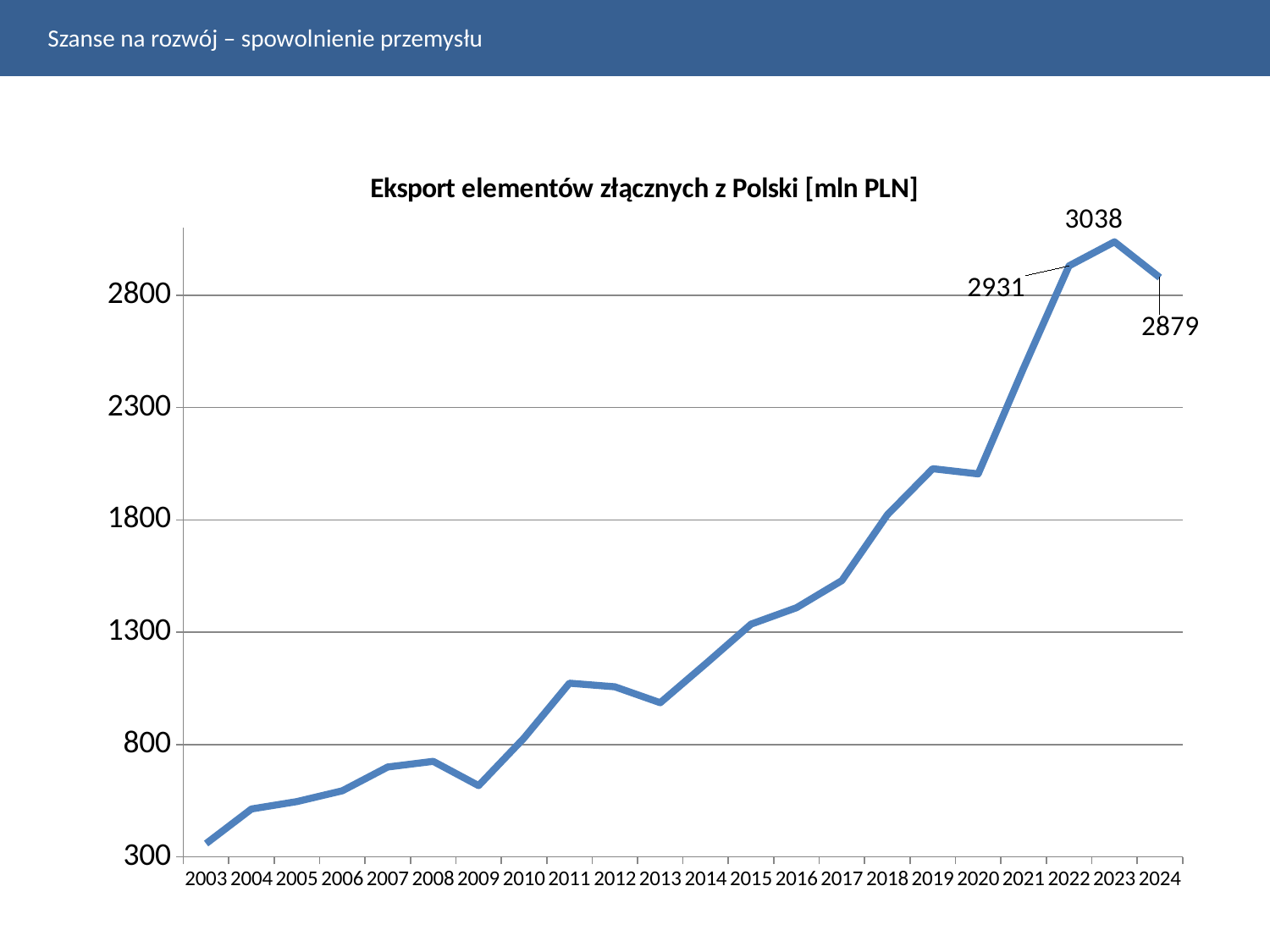
What is the difference between the values for 2023 and 2022? 107 What is the difference between the values for 2023 and 2024? 159 What is the value for 2022? 2931 How many years are plotted on the x axis? 22 Which year has the highest value? 2023 What is the value for 2024? 2879 What kind of chart is shown on the slide? line chart Is the value for 2021 greater or less than 2300? greater What is the value for 2023? 3038 Which year has the lowest value? 2003 Is the value for 2003 greater or less than 800? less Which is larger, the value for 2022 or the value for 2024? 2022